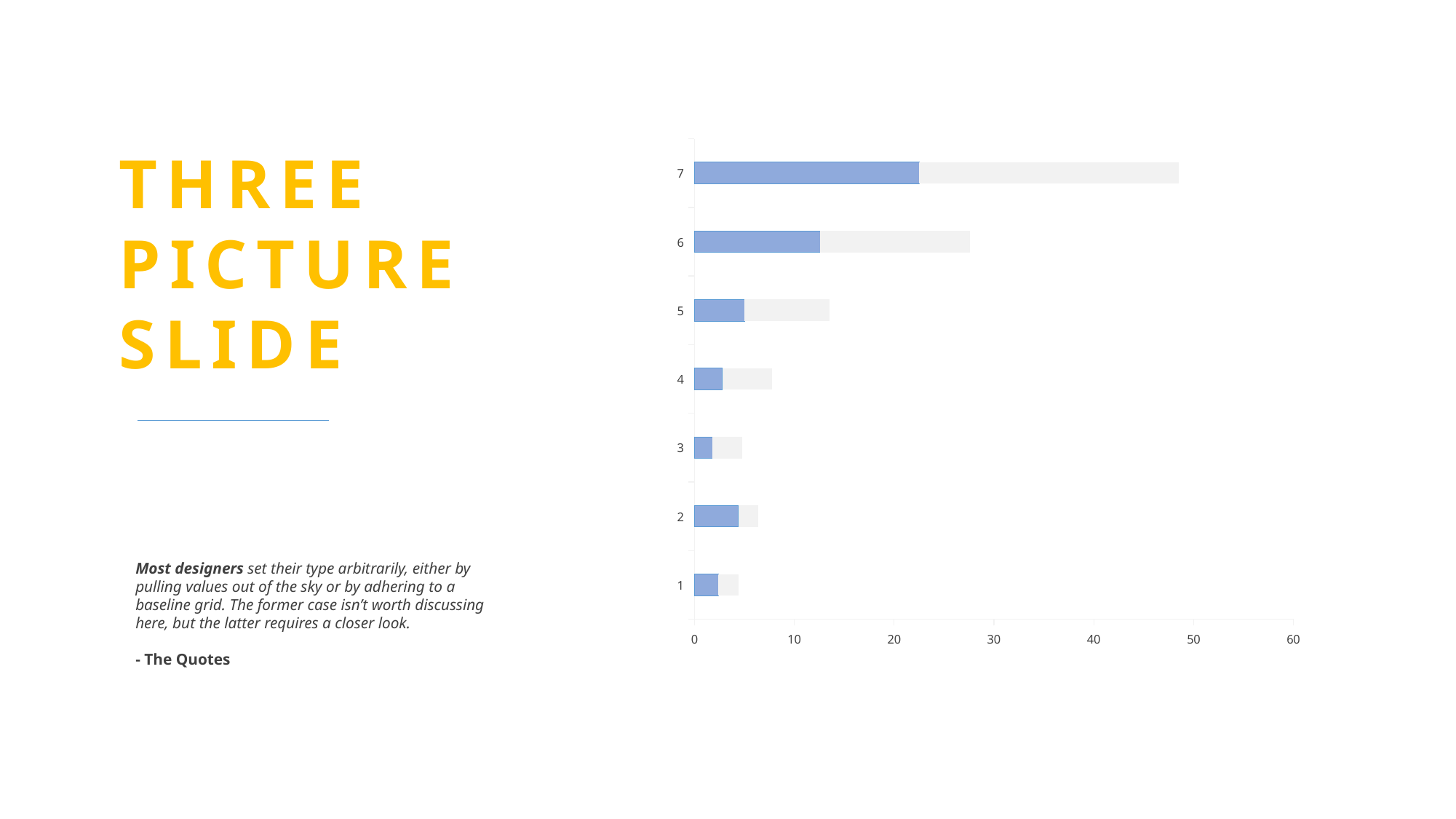
Is the blue segment for category 7 greater or less than 20? greater Which has the longer bar, category 5 or category 4? 5 Is the total length of the bar for category 5 greater or less than 10? greater Is the total length of the bar for category 7 greater or less than 50? less What kind of chart is shown on the slide? bar chart Which category has the longest bar in the chart? 7 Which has the longer bar, category 7 or category 6? 7 What is the highest value shown on the horizontal axis of the chart? 60 How many categories are shown on the vertical axis of the chart? 7